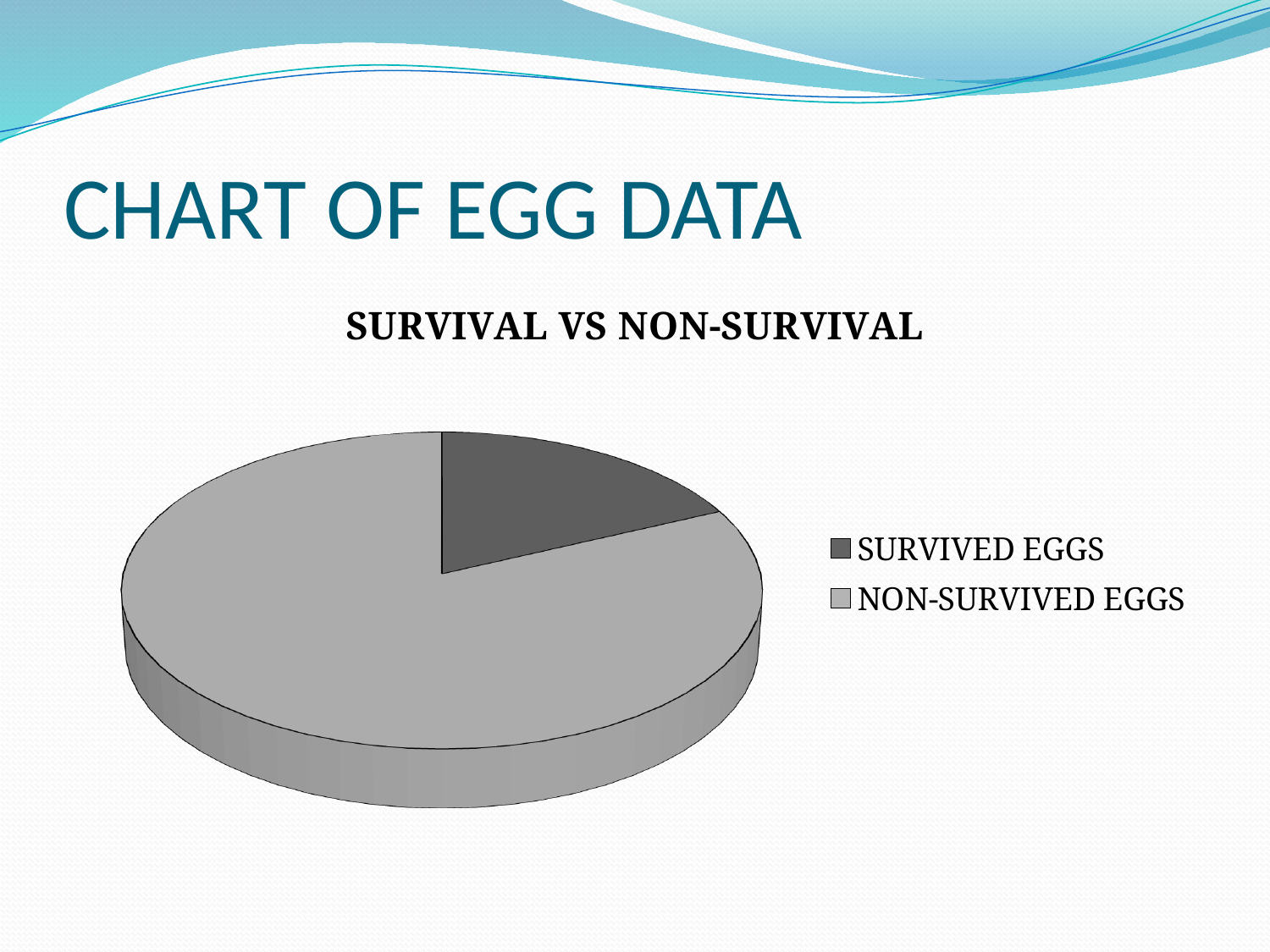
How many entries does the legend list? 2 What kind of chart is shown on the slide? pie chart Which category is shown in the darker grey colour? SURVIVED EGGS What is the title of the chart? SURVIVAL VS NON-SURVIVAL How many categories does the pie chart show? 2 Which category has the largest slice of the pie? NON-SURVIVED EGGS Which category has the smallest slice of the pie? SURVIVED EGGS Which slice is larger, SURVIVED EGGS or NON-SURVIVED EGGS? NON-SURVIVED EGGS